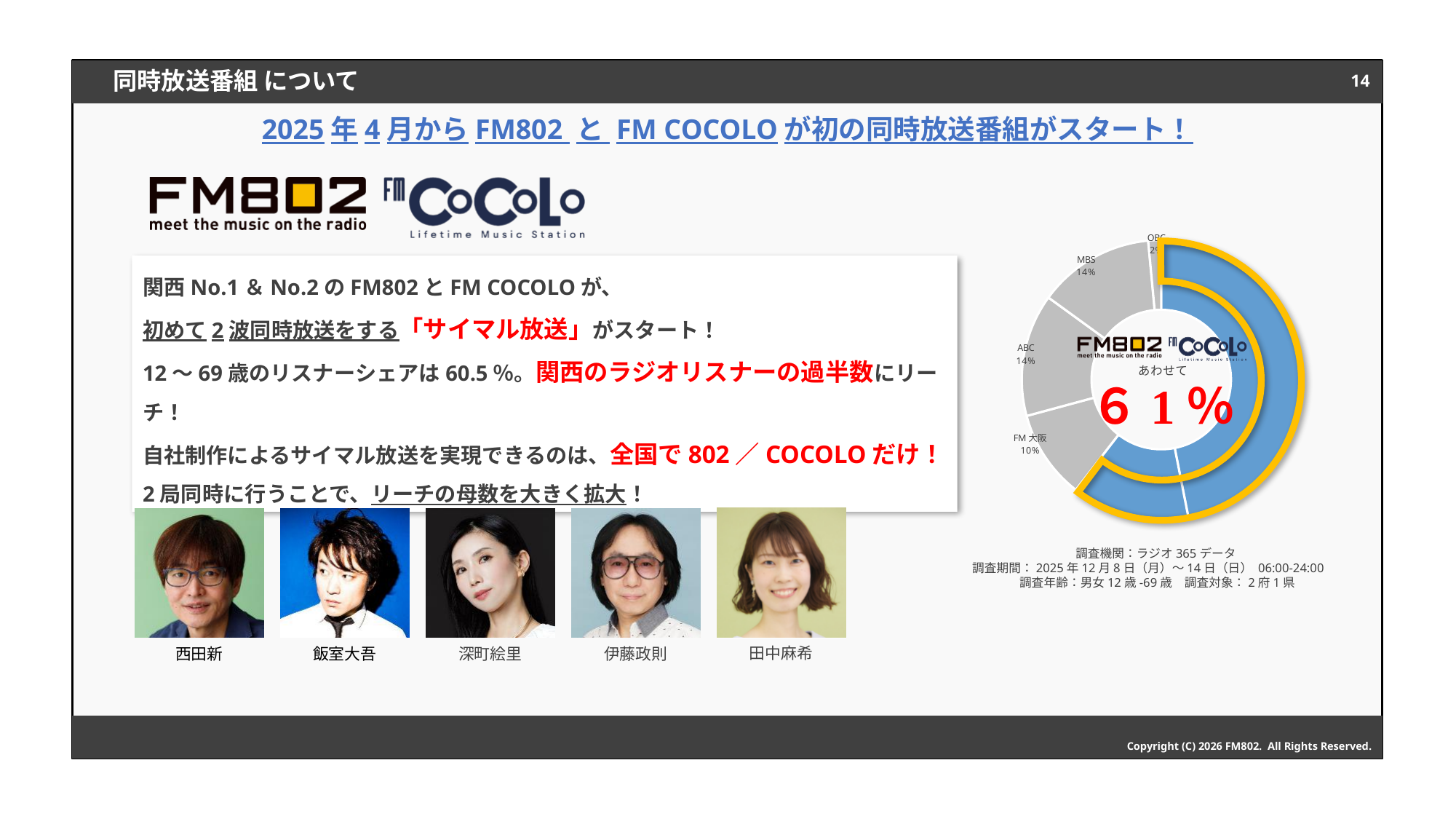
What is the difference between the combined FM802/FM COCOLO share and the ABC share in the pie chart? 47% What kind of chart is shown on the right side of the slide? doughnut chart What is the listener share shown for MBS in the pie chart? 14% What is the difference between the MBS share and the FM大阪 share in the pie chart? 4% What is the listener share shown for ABC in the pie chart? 14% What combined share is shown in the centre of the pie chart for FM802 and FM COCOLO? 61% Among MBS, ABC and FM大阪, which has the lowest share in the pie chart? FM大阪 What is the listener share shown for FM大阪 in the pie chart? 10% Which has the larger share in the pie chart, MBS or FM大阪? MBS What word appears above the 61% figure in the centre of the pie chart? あわせて What colour are the FM802 and FM COCOLO slices in the pie chart? blue Is the combined FM802 and FM COCOLO share in the pie chart greater or less than 50%? greater